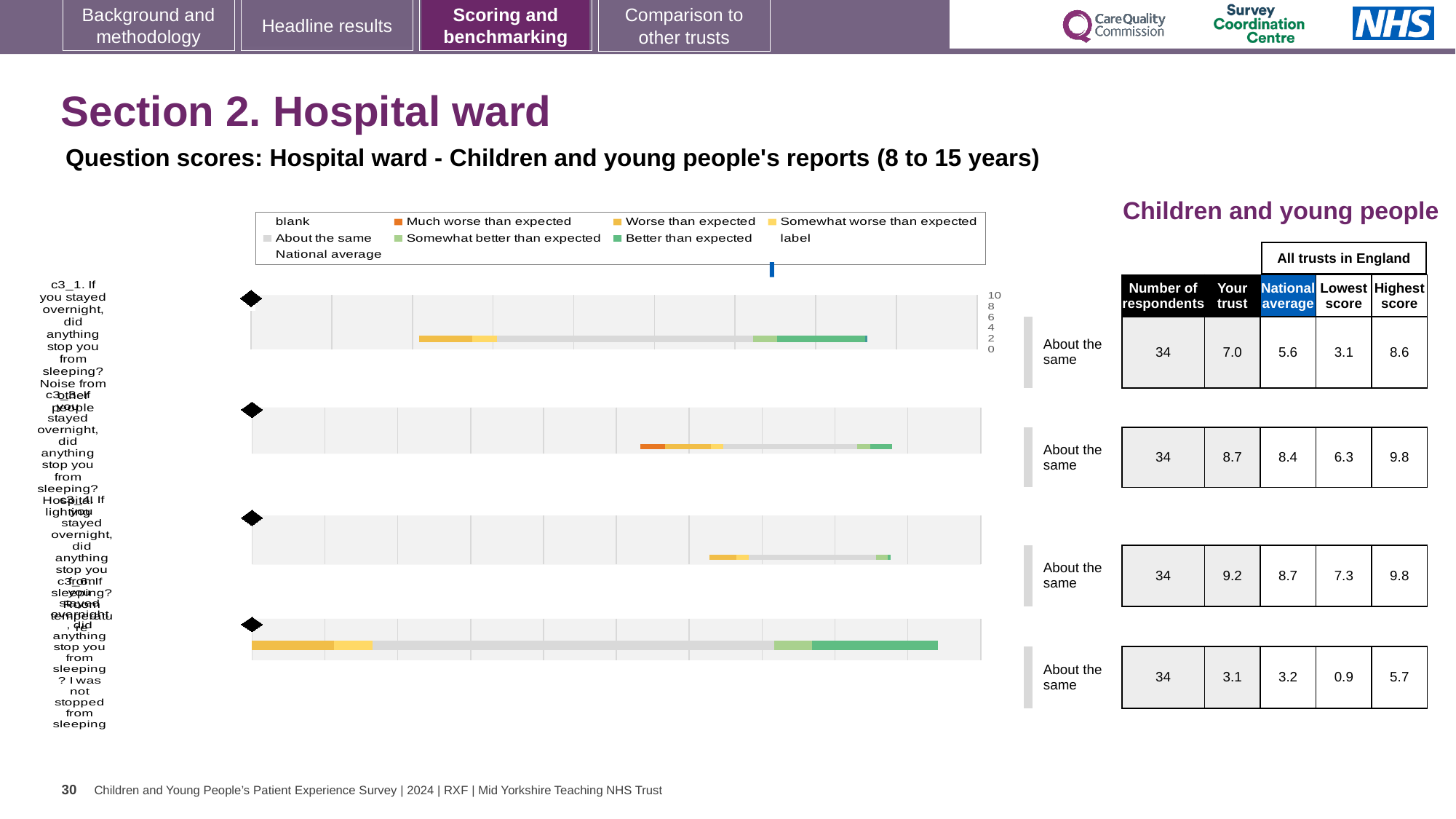
For the top chart (c3_1, noise from other people), what is the 'Your trust' score shown in the table? 7.0 Which of the four charts has the highest 'Your trust' score? the third chart from the top (9.2) What kind of chart is used to show the question scores on this slide? bar chart For the bottom chart (c3_6, I was not stopped from sleeping), what is the lowest score among all trusts in England? 0.9 For the second chart from the top, what is the difference between the highest score and the lowest score? 3.5 For the second chart from the top, what is the national average score shown in the table? 8.4 What benchmark label is printed to the right of each of the four bar charts? About the same How many separate bar charts are shown on the slide? 4 How many entries does the legend above the charts list? 9 In the legend, what colour represents 'Much worse than expected'? orange For the third chart from the top, what is the highest score among all trusts in England? 9.8 For the top chart, which is larger: the 'Your trust' score or the national average? Your trust